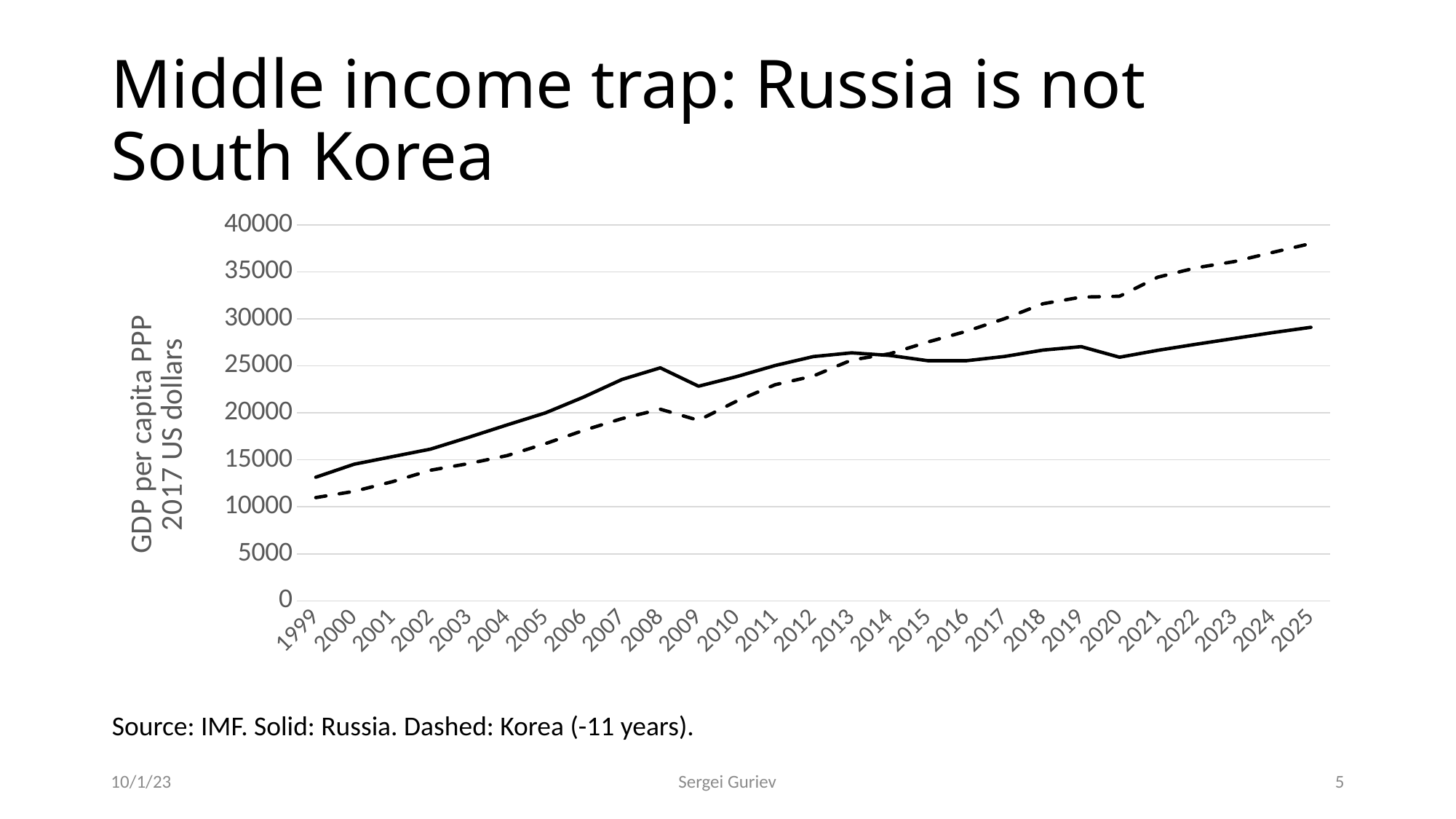
Is the value of the solid line (Russia) in 2025 greater or less than 30000? less What kind of chart is shown on the slide? line chart In 2025, which line is higher: the solid line (Russia) or the dashed line (Korea)? dashed (Korea) How many years are shown along the x axis of the chart? 27 In 2005, which line is higher: the solid line (Russia) or the dashed line (Korea)? solid (Russia) Is the value of the dashed line (Korea) in 2025 greater or less than 35000? greater What is the label of the vertical axis? GDP per capita PPP 2017 US dollars Is the value of the dashed line (Korea) in 2020 greater or less than 30000? greater How many lines (series) are plotted on the chart? 2 In which year does the solid line (Russia) reach its highest value? 2025 According to the caption, which country does the dashed line represent? Korea (-11 years)